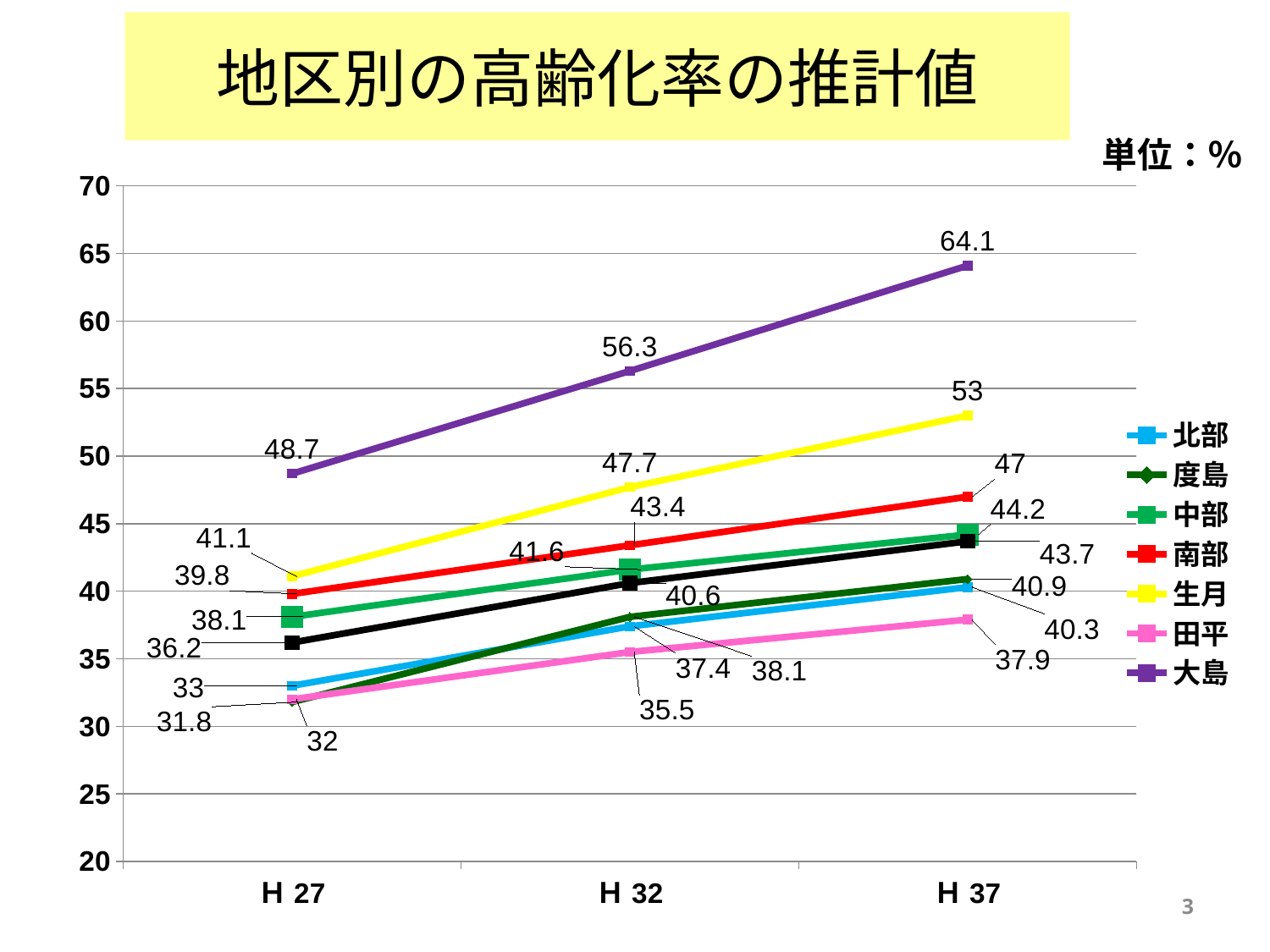
How many points are on the x axis? 3 Which district has the lowest value at H 37? 田平 What is the value for 大島 at H 37? 64.1 How many series does the legend list? 7 What is the title of the chart? 地区別の高齢化率の推計値 What kind of chart is shown on the slide? line chart By how much does the value for 大島 increase from H 27 to H 37? 15.4 What is the value for 生月 at H 32? 47.7 What is the value for 南部 at H 27? 39.8 Which district has the highest value at H 37? 大島 Does the value for 生月 rise or fall from H 27 to H 37? rise What is the value for 中部 at H 37? 44.2